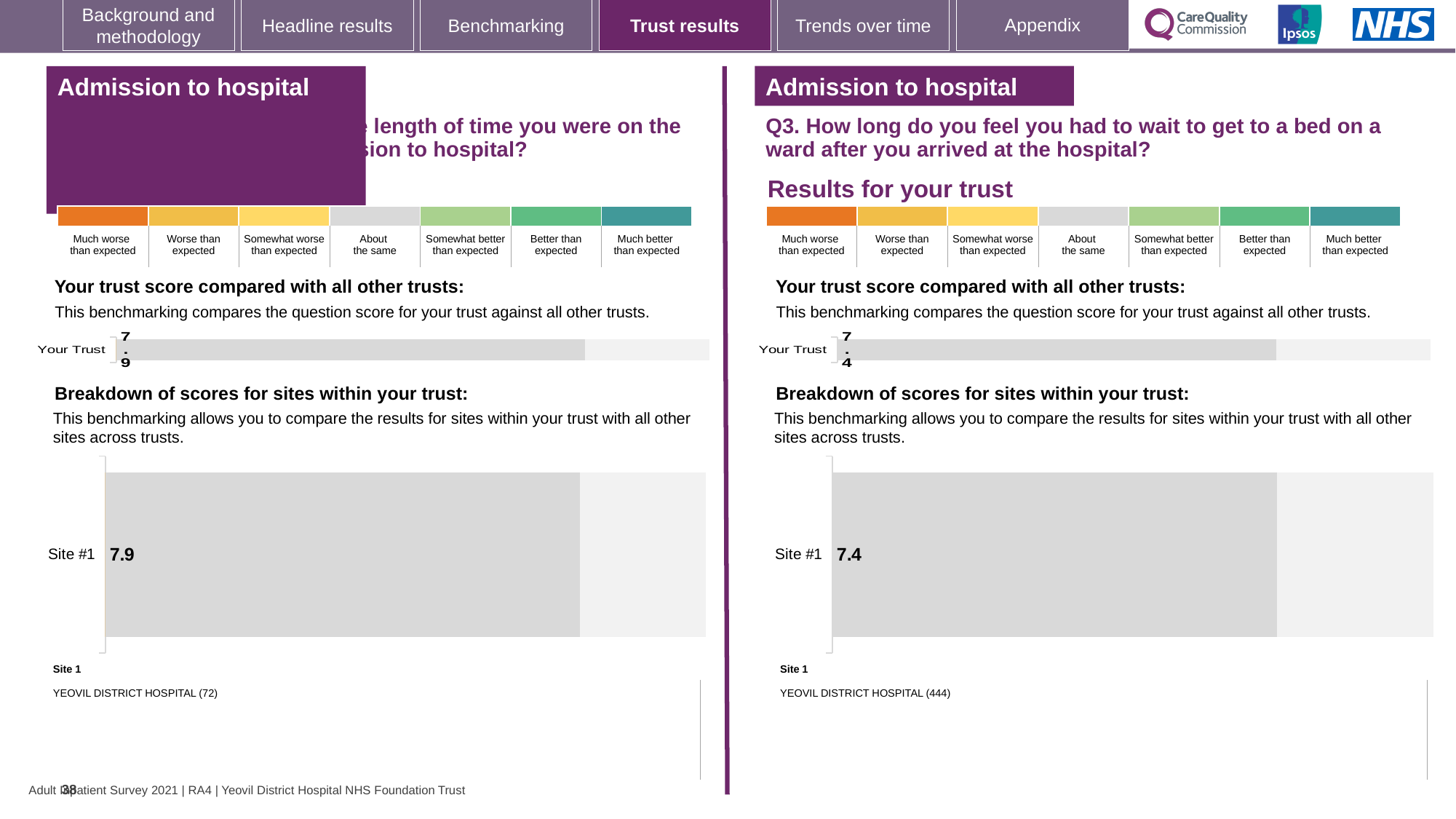
On the left panel, which site is listed as Site 1? YEOVIL DISTRICT HOSPITAL (72) On the right panel (Q3), what is the score shown for Your Trust? 7.4 Is the Your Trust score on the right panel (Q3) greater or less than 7.5? less What is the difference between the Site #1 score on the left panel and the Site #1 score on the right panel (Q3)? 0.5 On the right panel's (Q3) site breakdown chart, what is the score for Site #1? 7.4 On the right panel (Q3), which site is listed as Site 1? YEOVIL DISTRICT HOSPITAL (444) On the left panel, what is the score shown for Your Trust? 7.9 Which is larger: the Your Trust score on the left panel or the Your Trust score on the right panel (Q3)? Left panel (7.9) How many sites are shown in the site breakdown chart on the right panel (Q3)? 1 On the left panel's site breakdown chart, what is the score for Site #1? 7.9 What type of chart is used for the site breakdown on the left panel? Bar chart